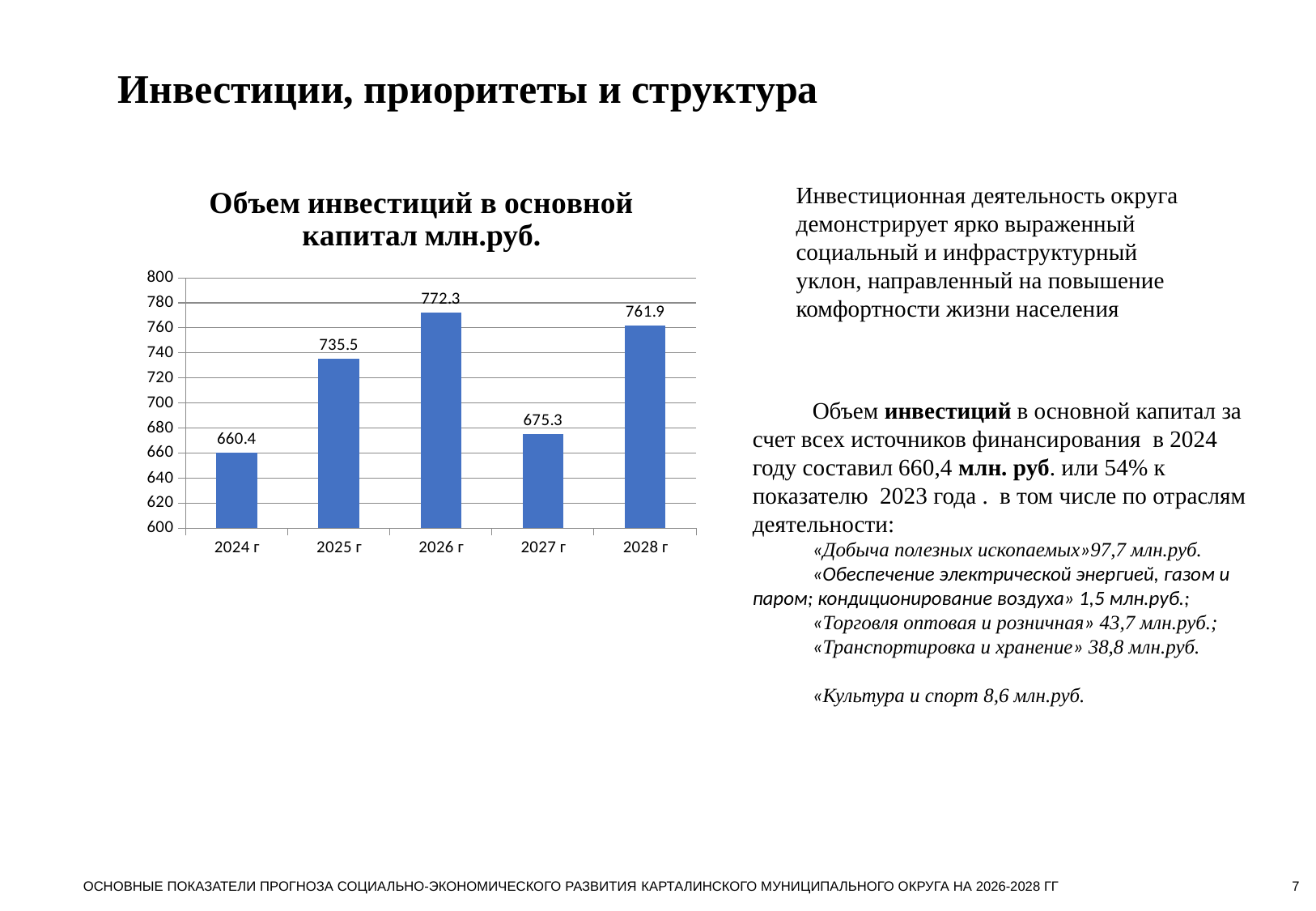
What is the title of the chart on the slide? Объем инвестиций в основной капитал млн.руб. What is the value for 2028 г in the chart? 761.9 What is the difference between the values for 2025 г and 2024 г? 75.1 Which year has the highest value in the chart? 2026 г What is the value for 2024 г in the chart 'Объем инвестиций в основной капитал млн.руб.'? 660.4 Which is larger, the value for 2025 г or the value for 2027 г? 2025 г How many years are shown in the chart? 5 Is the value for 2027 г greater or less than 700? less Which year has the lowest value in the chart? 2024 г What is the difference between the values for 2026 г and 2027 г? 97 What is the value for 2026 г in the chart? 772.3 What kind of chart is shown on the slide? bar chart